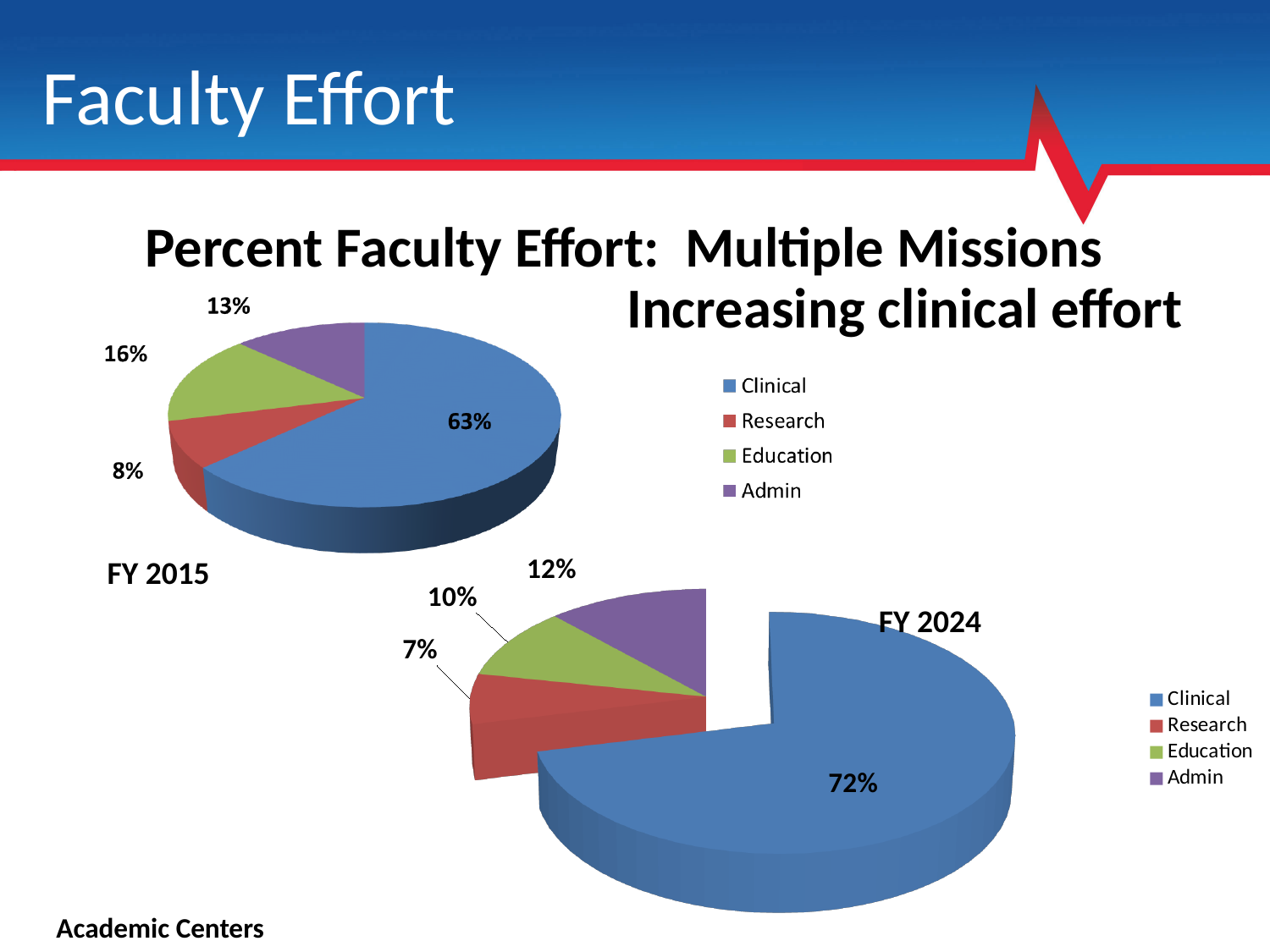
In the FY 2015 pie chart, which is larger, Education or Admin? Education In the FY 2024 pie chart, which category has the largest share? Clinical What is the difference between the Clinical share in FY 2024 and the Clinical share in FY 2015? 9% In the FY 2024 pie chart, what is the value for Research? 7% In the FY 2015 pie chart, what is the value for Clinical? 63% In the FY 2024 pie chart, what is the value for Clinical? 72% In the FY 2015 pie chart, what is the value for Education? 16% What type of chart is used for FY 2015? Pie chart In the FY 2015 pie chart, which category has the smallest share? Research How many categories does the FY 2024 pie chart show? 4 What is the title shown above the charts? Percent Faculty Effort: Multiple Missions In the FY 2024 pie chart, what is the difference between Admin and Education? 2%